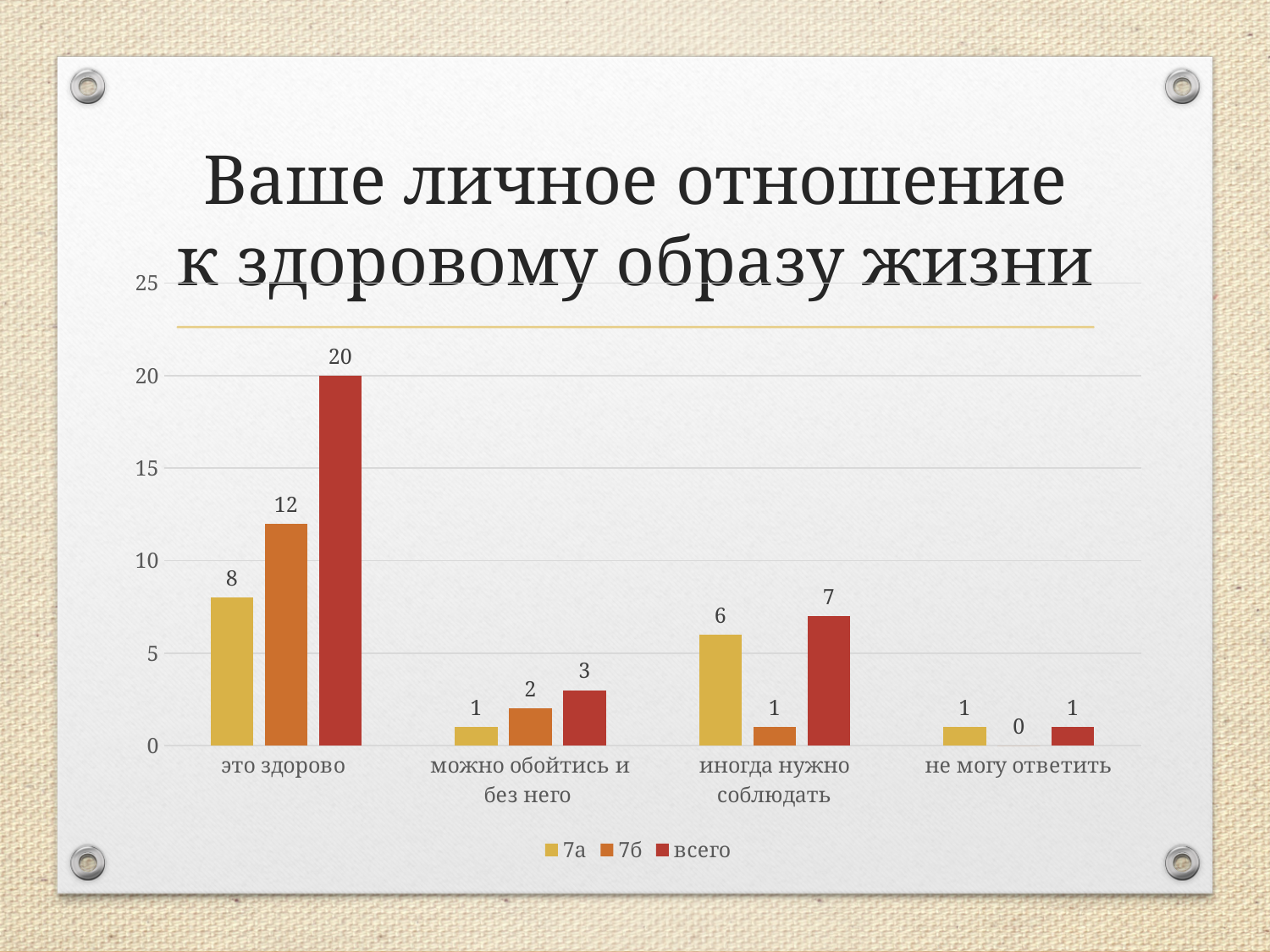
What kind of chart is shown on the slide? bar chart What is the difference between the 7б and 7а values in the category "это здорово"? 4 Which category has the highest value for всего? это здорово Which category has the lowest value for 7б? не могу ответить Which series is shown in yellow? 7а How many series does the legend list? 3 What is the value for 7а in the category "это здорово"? 8 What is the title of the chart? Ваше личное отношение к здоровому образу жизни How many categories are shown on the x axis? 4 What is the value for всего in the category "иногда нужно соблюдать"? 7 Which is larger in the category "иногда нужно соблюдать": the value for 7а or for 7б? 7а What is the value for 7б in the category "не могу ответить"? 0